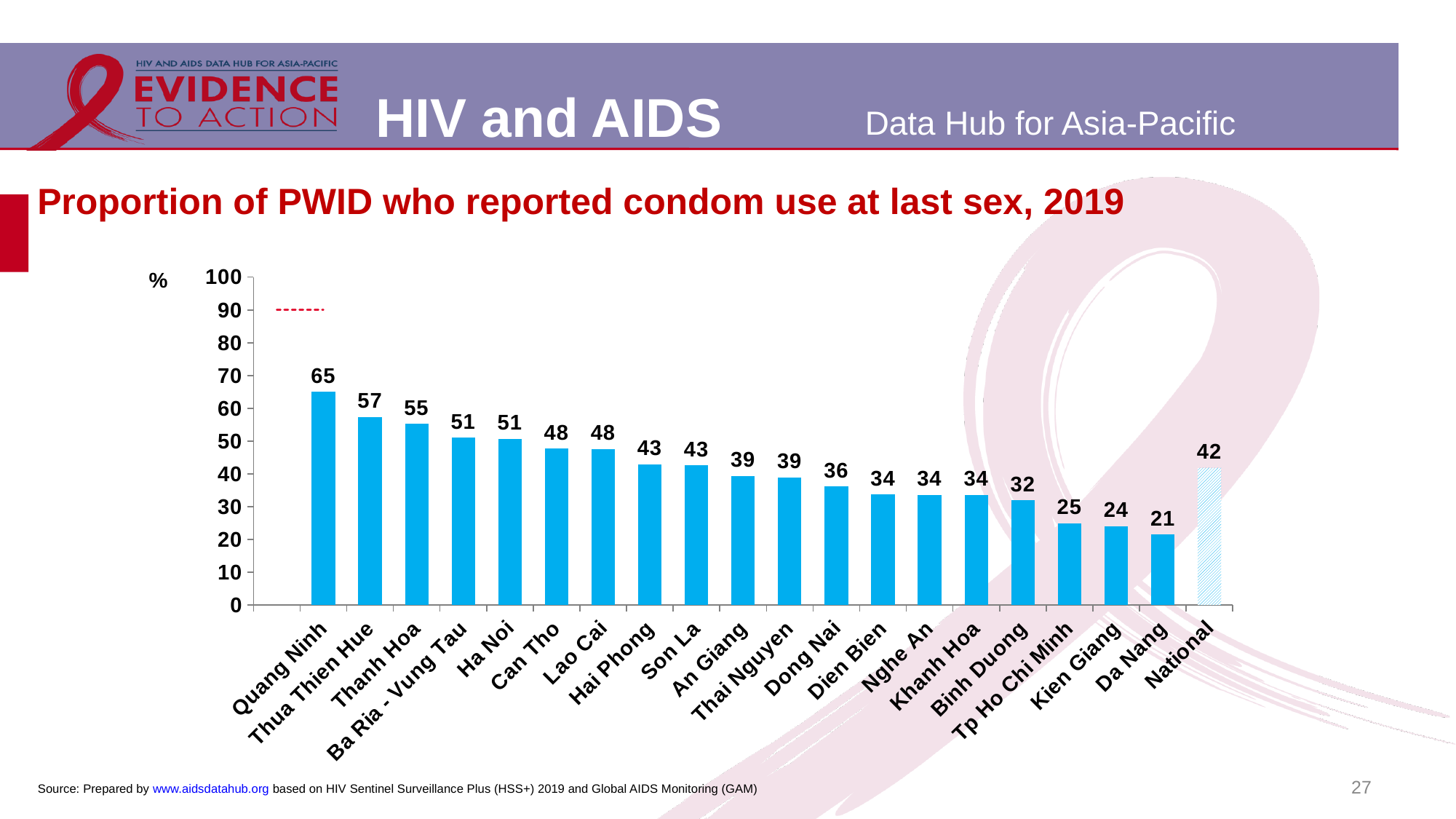
Which province has the highest proportion? Quang Ninh What is the National value? 42 What kind of chart is shown on the slide? Bar chart What is the value for Quang Ninh? 65 What is the value for Ha Noi? 51 What is the value for Tp Ho Chi Minh? 25 How many bars are shown on the chart, including National? 20 What is the difference between Quang Ninh and Da Nang? 44 Which province has the lowest proportion? Da Nang What is the title of the chart? Proportion of PWID who reported condom use at last sex, 2019 Do the province values rise or fall from left to right across the chart (excluding National)? Fall Which is larger, the value for Hai Phong or the value for Dong Nai? Hai Phong